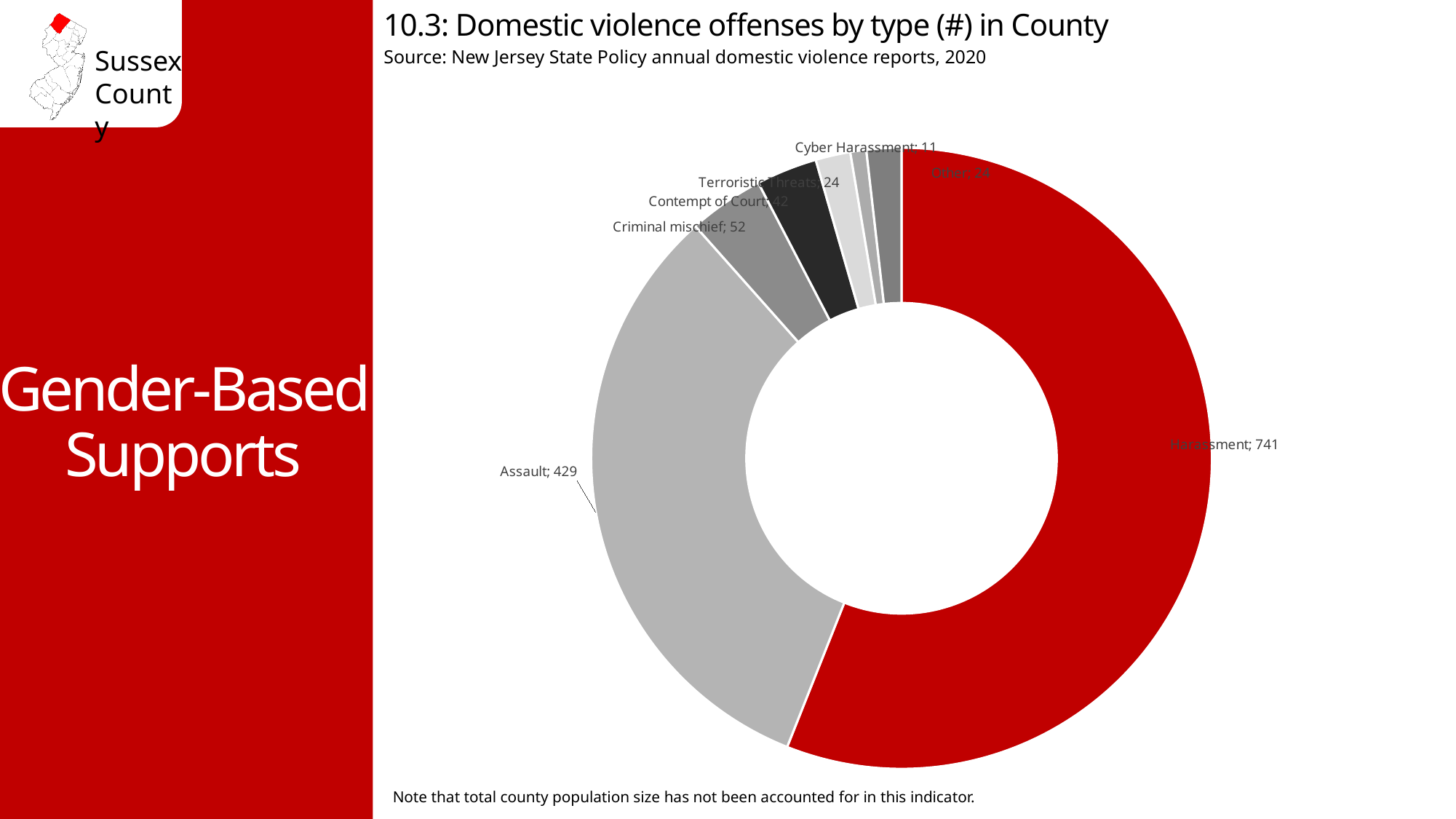
What is the value for Contempt of Court? 42 What is the difference between the number of Harassment offenses and Assault offenses? 312 What is the value for Assault? 429 What is the value for Criminal mischief? 52 How many domestic violence offenses of type Harassment are shown? 741 What is the value for Terroristic Threats? 24 What is the source cited for the chart? New Jersey State Policy annual domestic violence reports, 2020 Which offense type has the lowest number of offenses? Cyber Harassment What is the value for Cyber Harassment? 11 Which offense type has the highest number of offenses? Harassment Which is larger, Criminal mischief or Contempt of Court? Criminal mischief What type of chart is shown on the slide? Doughnut (pie) chart